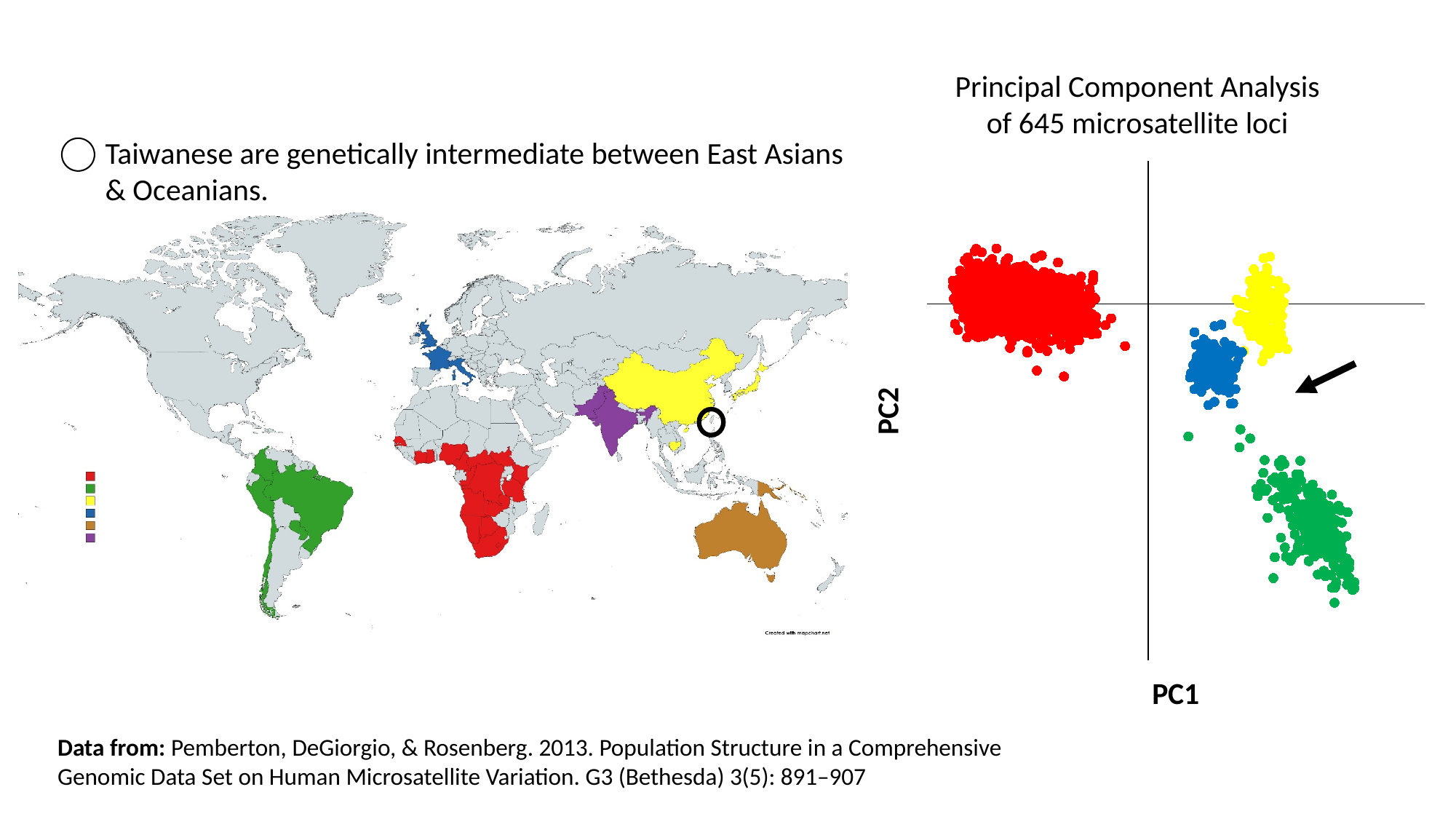
What is the title of the chart on the right side of the slide? Principal Component Analysis of 645 microsatellite loci In the Principal Component Analysis chart, which cluster is positioned higher on the PC2 axis, the yellow cluster or the blue cluster? Yellow In the Principal Component Analysis chart, which coloured cluster lies furthest left on the PC1 axis? Red In the Principal Component Analysis chart, which cluster is positioned further left on the PC1 axis, the red cluster or the yellow cluster? Red What kind of chart is shown on the right side of the slide? Scatter chart In the Principal Component Analysis chart, which cluster is positioned higher on the PC2 axis, the blue cluster or the green cluster? Blue In the Principal Component Analysis chart, which coloured cluster lies lowest on the PC2 axis? Green In the Principal Component Analysis chart, how many differently coloured clusters of points are plotted? 4 In the Principal Component Analysis chart, which coloured cluster extends furthest right on the PC1 axis? Green In the Principal Component Analysis chart, what is the label of the horizontal axis? PC1